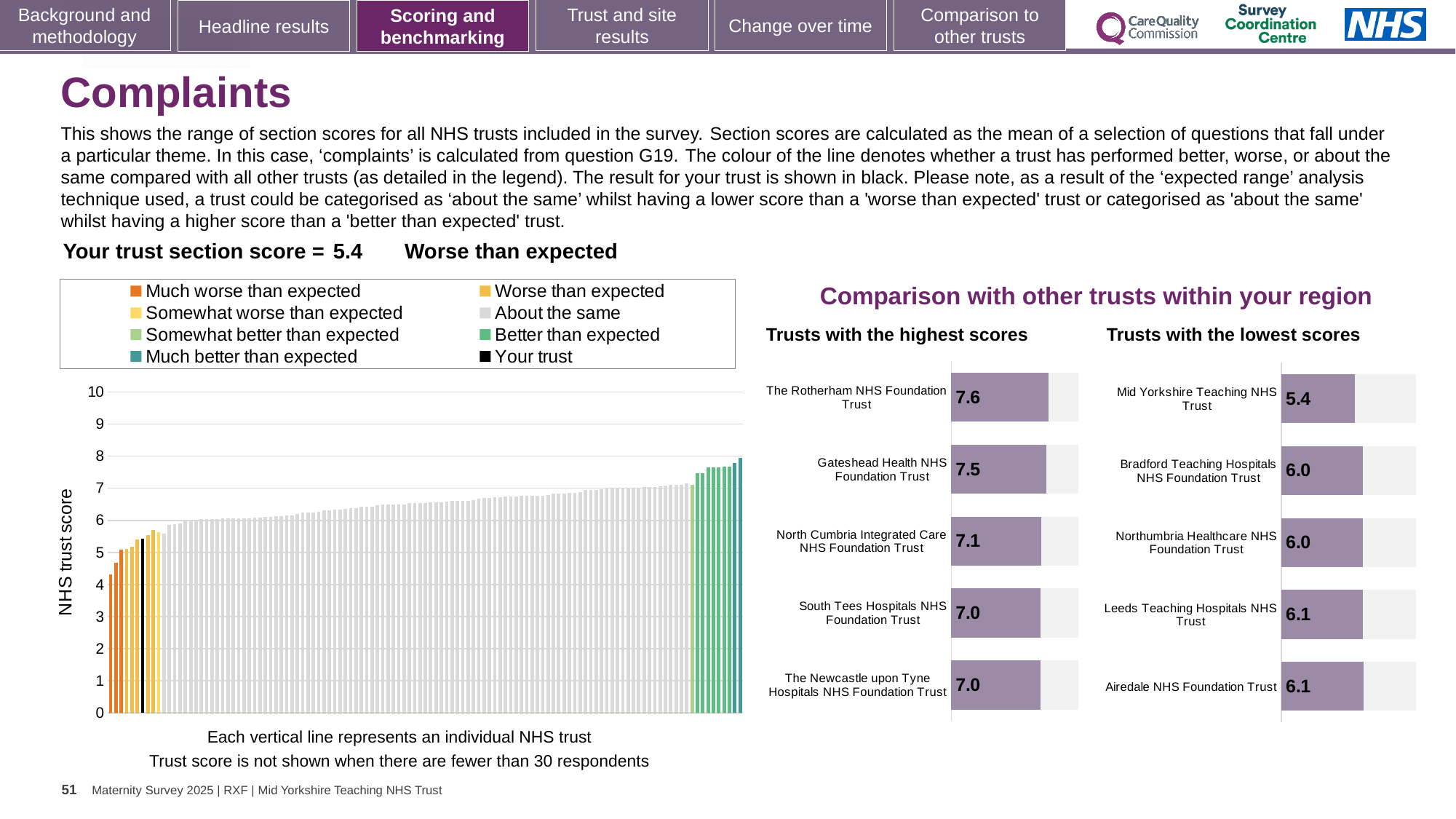
In the 'Trusts with the lowest scores' chart, what is the score for Mid Yorkshire Teaching NHS Trust? 5.4 In the 'Trusts with the highest scores' chart, which has the higher score: Gateshead Health NHS Foundation Trust or North Cumbria Integrated Care NHS Foundation Trust? Gateshead Health NHS Foundation Trust In the 'Trusts with the lowest scores' chart, which trust has the lowest score? Mid Yorkshire Teaching NHS Trust In the 'Trusts with the highest scores' chart, what is the score for The Rotherham NHS Foundation Trust? 7.6 In the 'NHS trust score' chart, do the bar values rise or fall from left to right? Rise In the 'Trusts with the highest scores' chart, which trust has the highest score? The Rotherham NHS Foundation Trust How many trusts are shown in the 'Trusts with the highest scores' chart? 5 In the 'Trusts with the lowest scores' chart, what is the score for Leeds Teaching Hospitals NHS Trust? 6.1 In the 'Trusts with the highest scores' chart, what is the difference between the scores of The Rotherham NHS Foundation Trust and Gateshead Health NHS Foundation Trust? 0.1 What kind of chart is the 'NHS trust score' chart on the left? Bar chart How many entries does the legend of the 'NHS trust score' chart list? 8 In the 'Trusts with the lowest scores' chart, what is the difference between the scores of Bradford Teaching Hospitals NHS Foundation Trust and Mid Yorkshire Teaching NHS Trust? 0.6